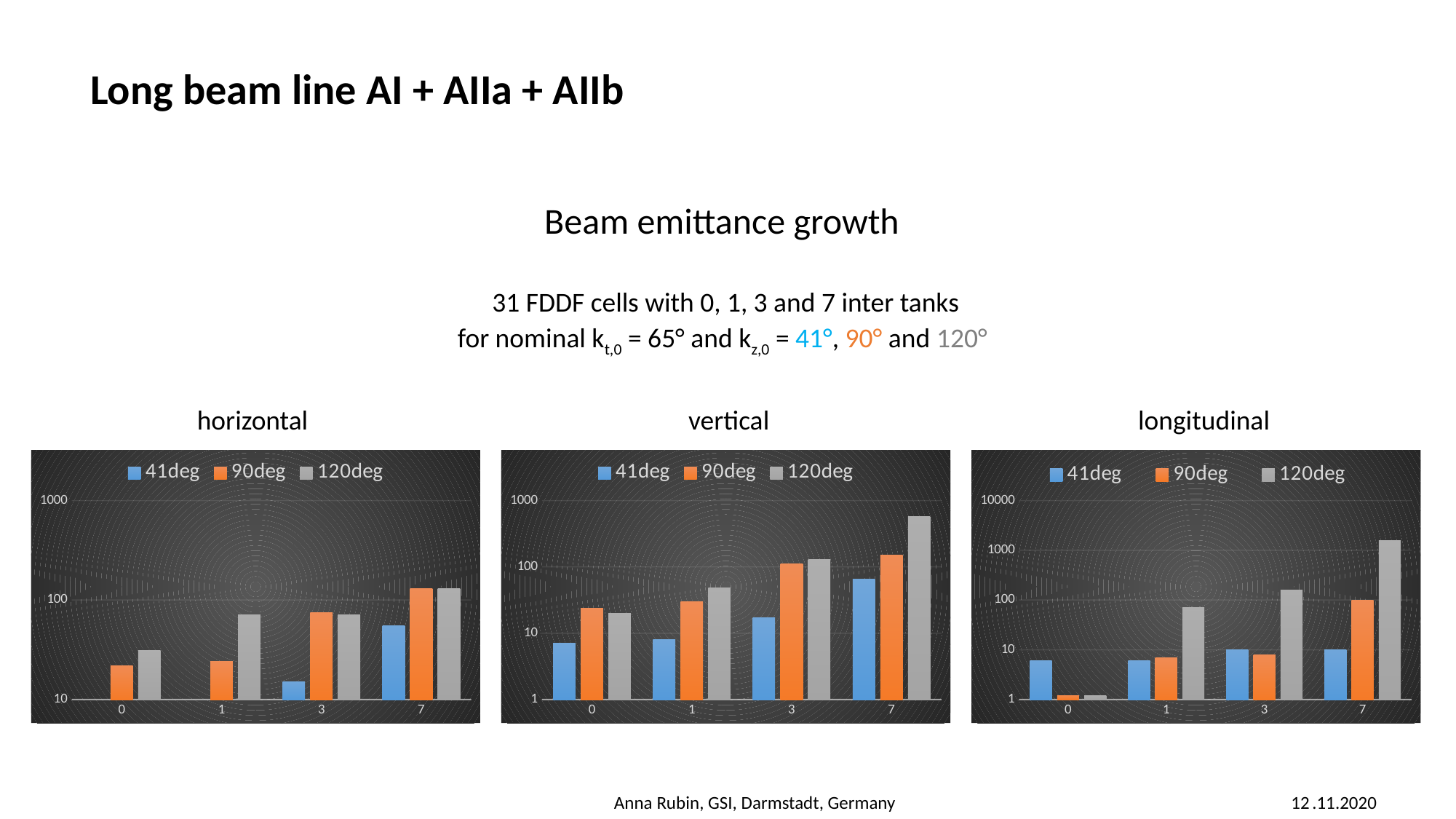
In the 'horizontal' chart, is the value for 120deg at category 1 greater or less than 100? less What is the highest tick label on the y axis of the 'longitudinal' chart? 10000 What kind of chart is the 'horizontal' chart? bar chart In the 'vertical' chart, which is larger at category 1: the 41deg value or the 120deg value? 120deg In the 'horizontal' chart, is the value for 90deg at category 7 greater or less than 100? greater In the 'longitudinal' chart, is the value for 120deg at category 7 greater or less than 1000? greater In the 'longitudinal' chart, which series has the lowest value at category 3? 90deg In the 'vertical' chart, do the 41deg values rise or fall as the category increases from 0 to 7? rise How many categories are shown on the x axis of the 'longitudinal' chart? 4 In the 'vertical' chart, which series has the highest value at category 7? 120deg How many series does the legend of the 'vertical' chart list? 3